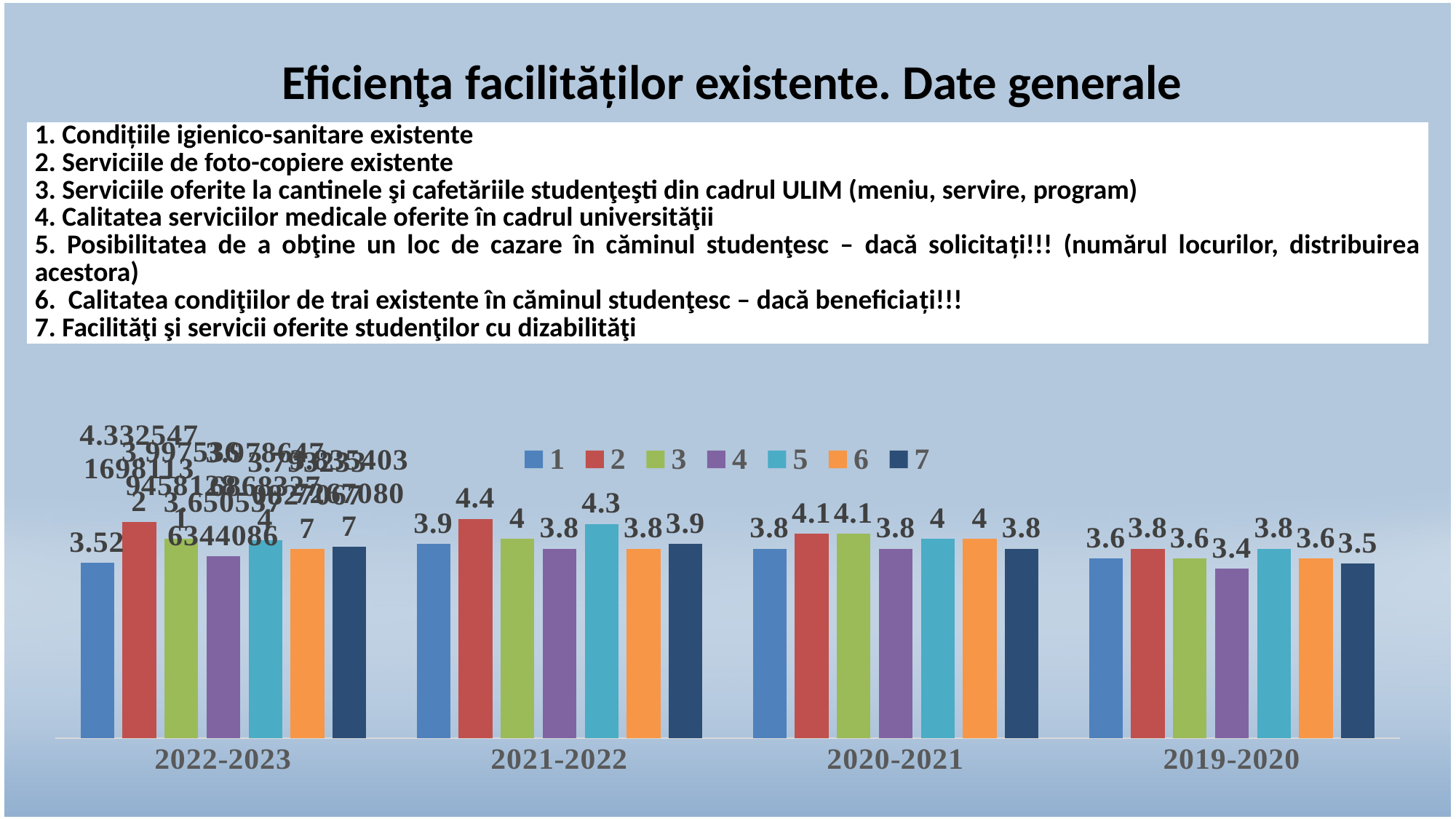
What is the value for series 2 in 2021-2022? 4.4 What kind of chart is shown on the slide? bar chart What is the value for series 4 in 2019-2020? 3.4 Which is larger in 2020-2021: the value for series 2 or the value for series 7? series 2 How many academic-year categories are shown on the x axis of the chart? 4 Which category on the x axis is listed first, at the far left of the chart? 2022-2023 What is the difference between the values for series 2 and series 4 in 2021-2022? 0.6 What is the value for series 1 in 2020-2021? 3.8 How many series does the chart legend list? 7 What is the value for series 5 in 2021-2022? 4.3 Which series has the highest value in the 2021-2022 group? 2 Which series has the lowest value in the 2019-2020 group? 4